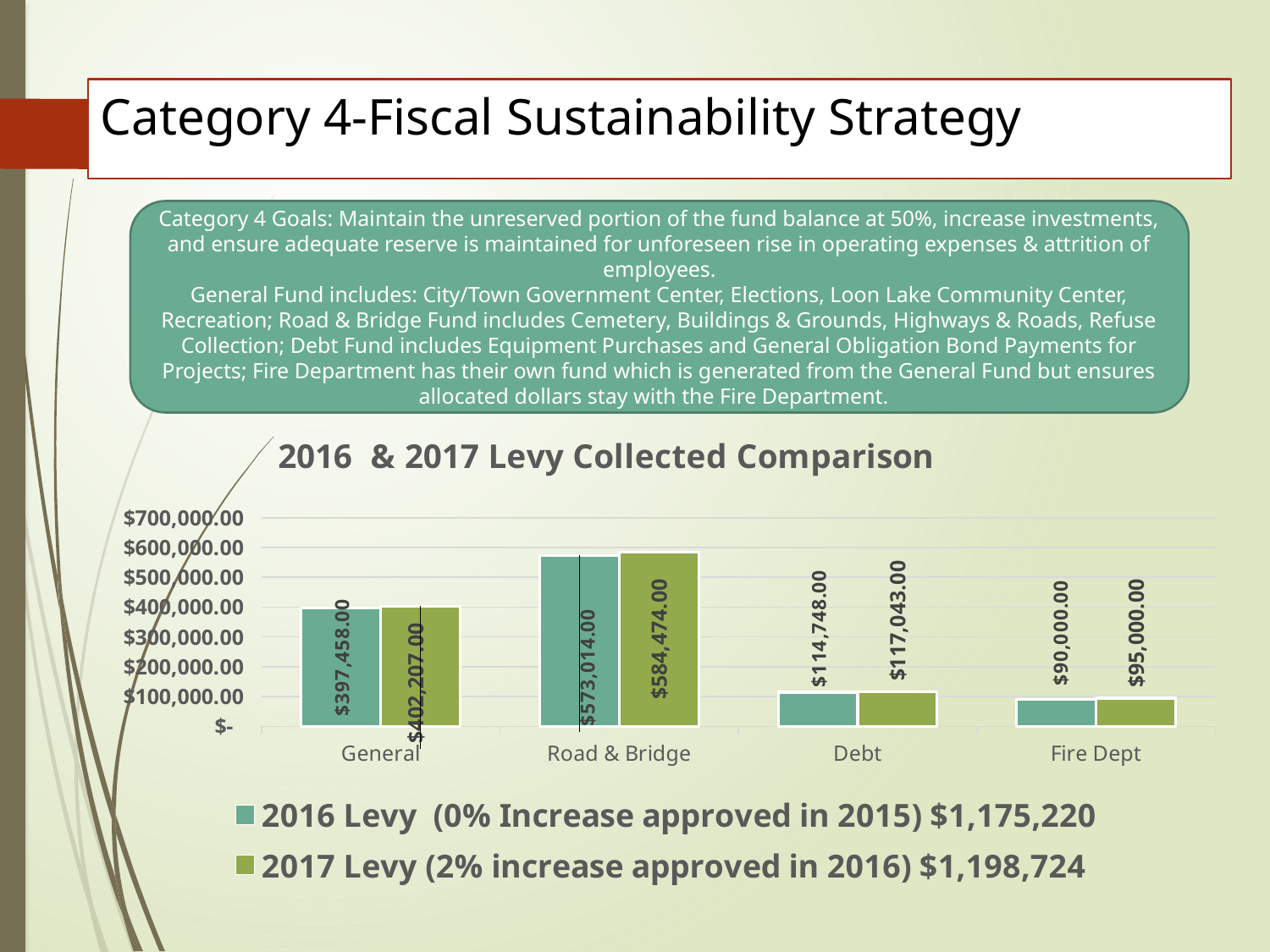
What is the 2016 Levy value for Road & Bridge? $573,014.00 Is the 2016 Levy value for General greater or less than $300,000.00? greater Which category has the highest 2017 Levy value? Road & Bridge What is the 2017 Levy value for General? $402,207.00 What type of chart is shown on the slide? Bar chart What is the 2016 Levy value for Debt? $114,748.00 Which is larger for Debt: the 2016 Levy or the 2017 Levy? 2017 Levy What is the difference between the 2017 Levy and 2016 Levy values for Road & Bridge? $11,460.00 Which category has the lowest 2016 Levy value? Fire Dept How many categories are shown on the x axis? 4 What is the 2017 Levy value for Fire Dept? $95,000.00 How many series does the legend list? 2